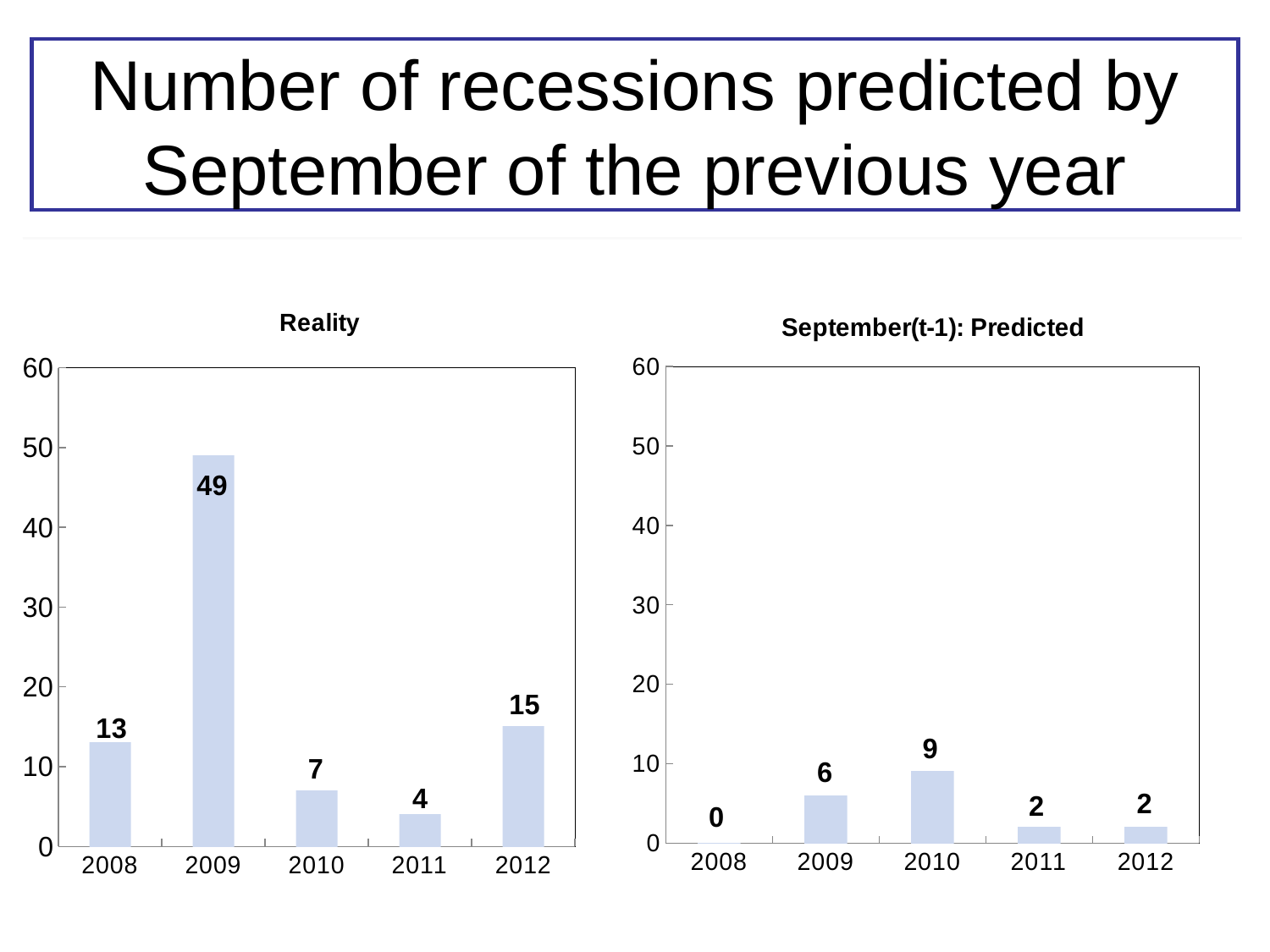
In the "September(t-1): Predicted" chart, which year has the highest value? 2010 In the "September(t-1): Predicted" chart, what is the value for 2010? 9 What kind of chart is the "September(t-1): Predicted" chart? bar chart In the "Reality" chart, which year has the highest value? 2009 In the "Reality" chart, what is the difference between the values for 2009 and 2012? 34 In the "Reality" chart, which year has the lowest value? 2011 In the "September(t-1): Predicted" chart, which year has the lowest value? 2008 In the "September(t-1): Predicted" chart, what is the difference between the values for 2010 and 2009? 3 In the "Reality" chart, which is larger, the value for 2008 or the value for 2012? 2012 How many years are shown on the x axis of the "Reality" chart? 5 In the "Reality" chart, what is the value for 2009? 49 What is the title of the chart on the left side of the slide? Reality